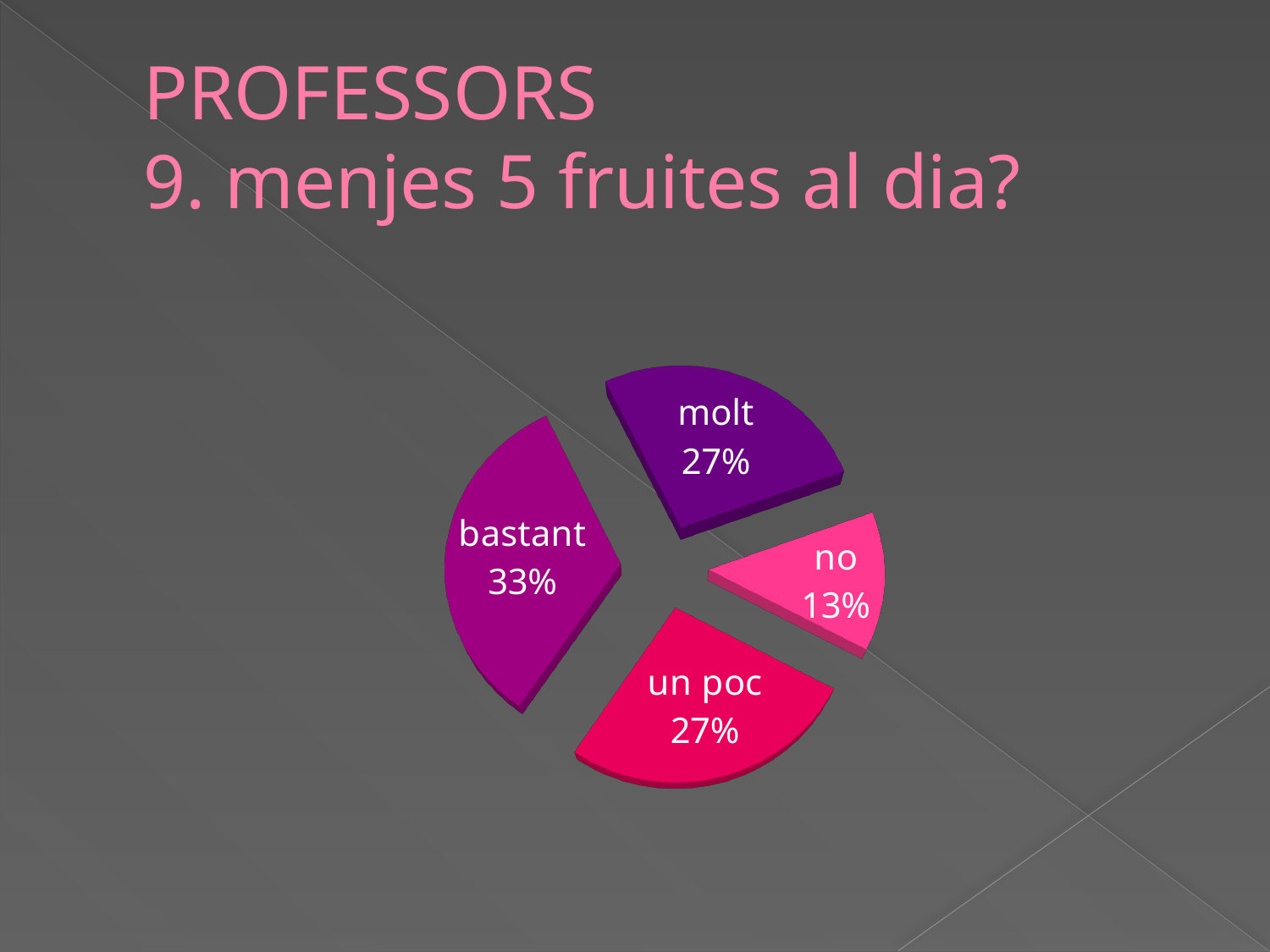
Which slice of the pie is the largest? bastant What is the difference in percentage points between the "bastant" slice and the "no" slice? 20 What percentage of the pie is labelled "no"? 13% What percentage of the pie is labelled "molt"? 27% What percentage of the pie is labelled "un poc"? 27% What is the difference in percentage points between the "molt" slice and the "no" slice? 14 Which is larger, the "bastant" slice or the "molt" slice? bastant What percentage of the pie is labelled "bastant"? 33% Which slice of the pie is the smallest? no What question is the pie chart on the slide about? 9. menjes 5 fruites al dia? How many slices does the pie chart have? 4 What kind of chart is shown on the slide? pie chart